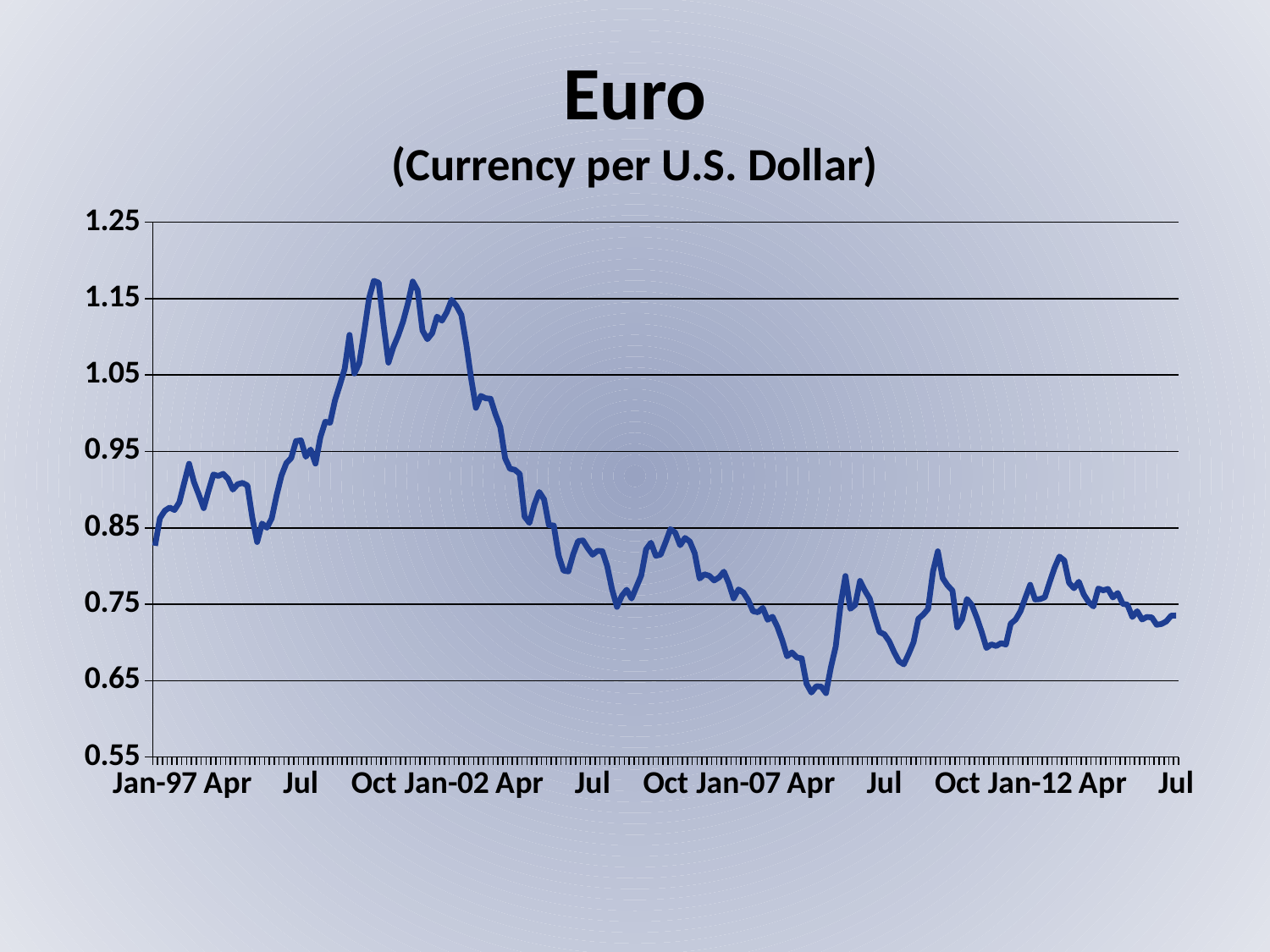
Is the peak value of the line greater or less than 1.15? greater Is the value at Jan-12 greater or less than 0.85? less What kind of chart is shown on the slide? line chart Is the value at Jan-97 greater or less than 0.75? greater Does the line generally rise or fall between Jan-97 and Jan-02? rise What is the title of the chart? Euro (Currency per U.S. Dollar) Does the line generally rise or fall between Jan-02 and Jan-07? fall What is the highest value shown on the vertical axis? 1.25 Which is larger, the value at Jan-02 or the value at Jan-12? Jan-02